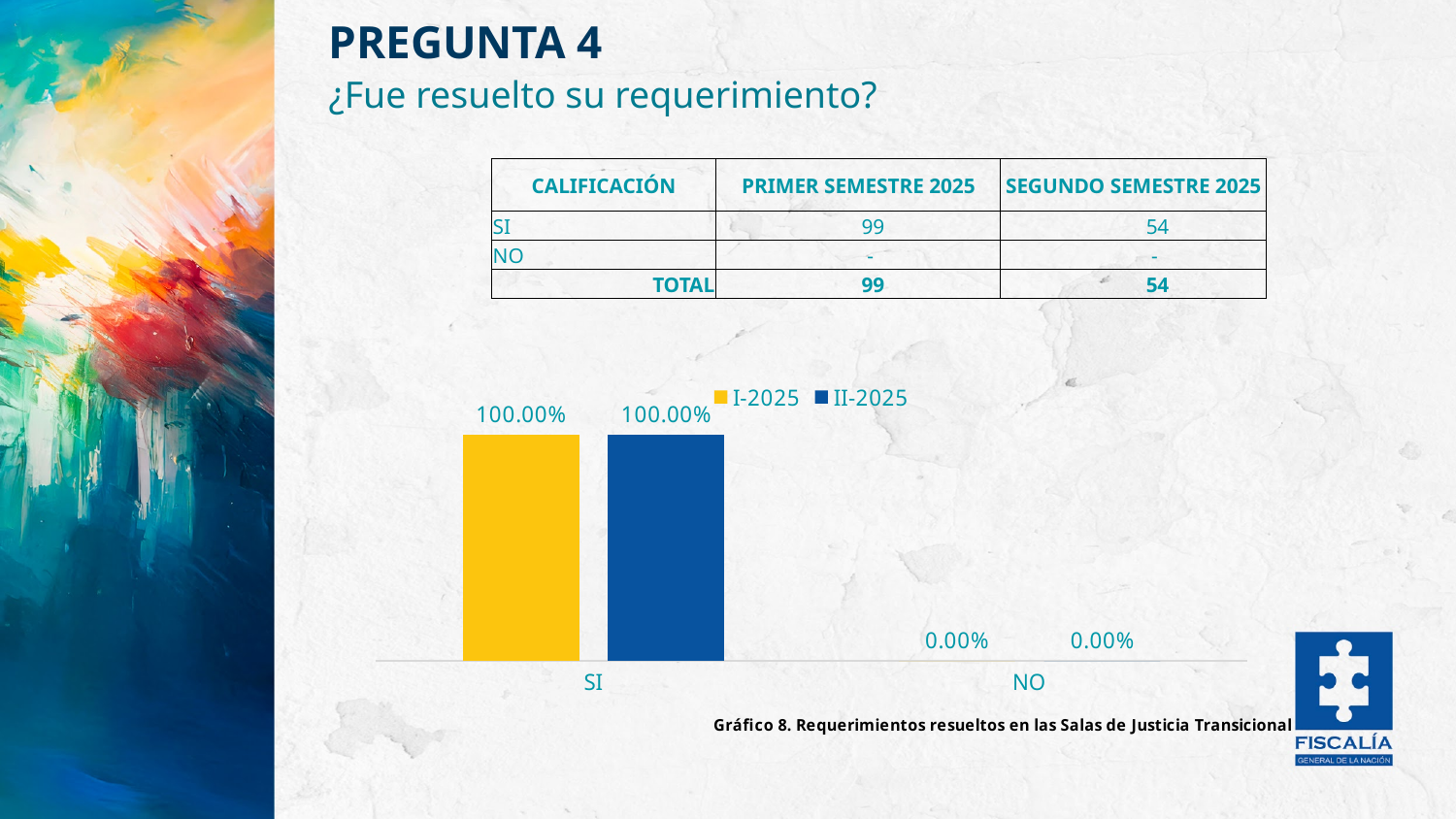
What is the difference between the SI and NO values in the I-2025 series? 100.00% What is the value for SI in the I-2025 series? 100.00% What are the two series names listed in the chart legend? I-2025 and II-2025 How many categories are shown on the x axis of the chart? 2 How many series does the chart legend list? 2 What is the value for SI in the II-2025 series? 100.00% What kind of chart is shown on the slide? bar chart What colour are the bars for the I-2025 series? yellow What is the value for NO in the II-2025 series? 0.00% Which category has the highest value in the I-2025 series? SI Which category has the lowest value in the II-2025 series? NO Which is larger in the II-2025 series, SI or NO? SI